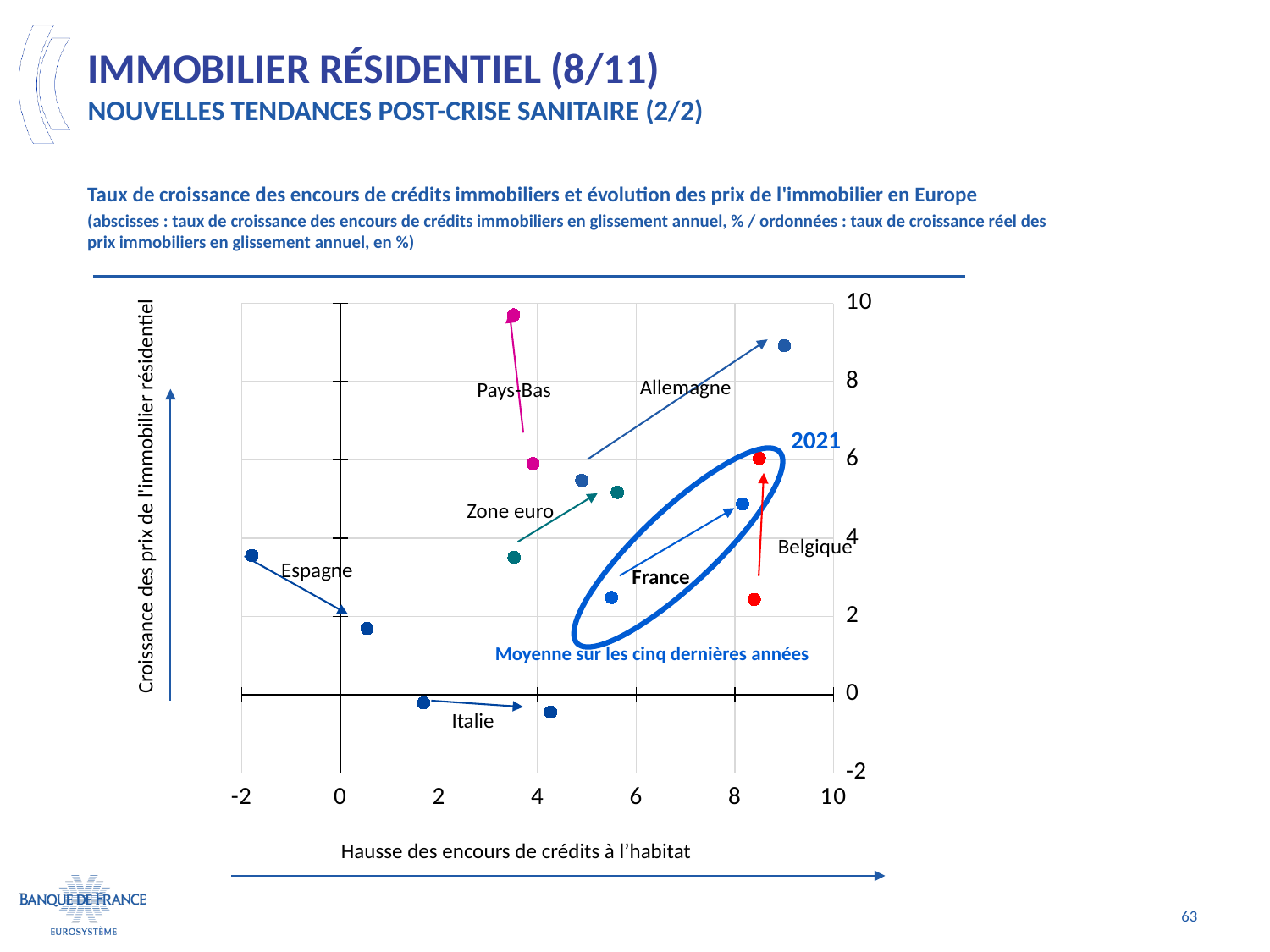
Is the 2021 value for Pays-Bas on the vertical axis greater or less than 8? greater What is the title of the chart? Taux de croissance des encours de crédits immobiliers et évolution des prix de l'immobilier en Europe Is the 2021 value for Belgique on the horizontal axis greater or less than 8? greater Which labelled country has the highest point on the vertical axis? Pays-Bas Is the 2021 value for Italie on the vertical axis greater or less than 0? less Which labelled country has the point furthest to the left on the horizontal axis? Espagne Which is higher on the vertical axis: the 2021 point for Pays-Bas or the 2021 point for Allemagne? Pays-Bas What kind of chart is shown on the slide? Scatter chart What label is written along the vertical axis of the chart? Croissance des prix de l'immobilier résidentiel How many countries or regions are labelled on the chart? 7